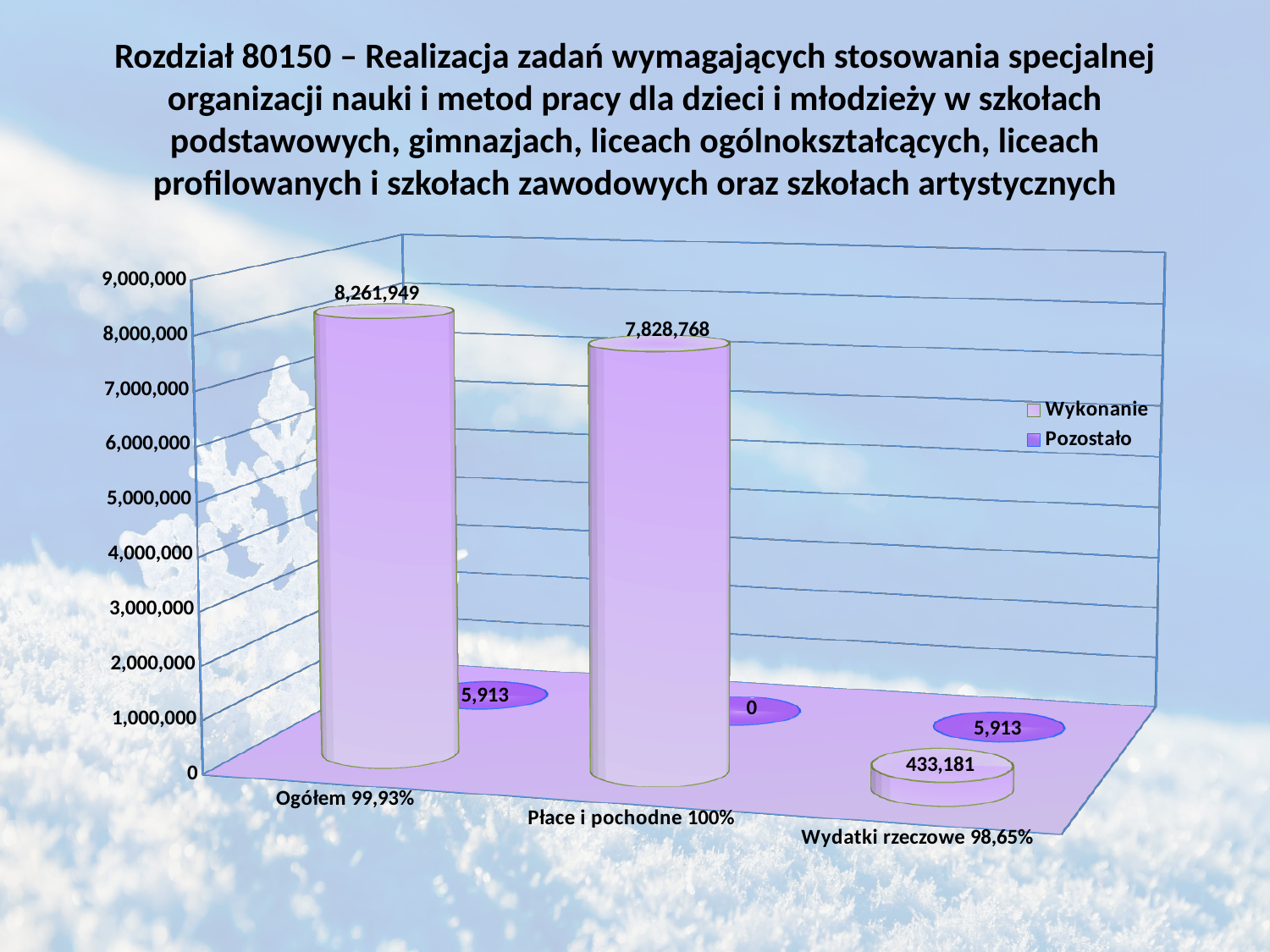
Which category has the highest Wykonanie value? Ogółem 99,93% What is the Wykonanie value for Płace i pochodne 100%? 7,828,768 How many series does the legend list? 2 How many categories are shown on the x axis? 3 Which category has the lowest Wykonanie value? Wydatki rzeczowe 98,65% What is the Wykonanie value for Ogółem 99,93%? 8,261,949 What is the Pozostało value for Wydatki rzeczowe 98,65%? 5,913 What is the difference between the Wykonanie values for Ogółem 99,93% and Płace i pochodne 100%? 433,181 What is the Wykonanie value for Wydatki rzeczowe 98,65%? 433,181 What is the Pozostało value for Płace i pochodne 100%? 0 What kind of chart is shown on the slide? Bar chart Which is larger: the Wykonanie value for Płace i pochodne 100% or for Wydatki rzeczowe 98,65%? Płace i pochodne 100%